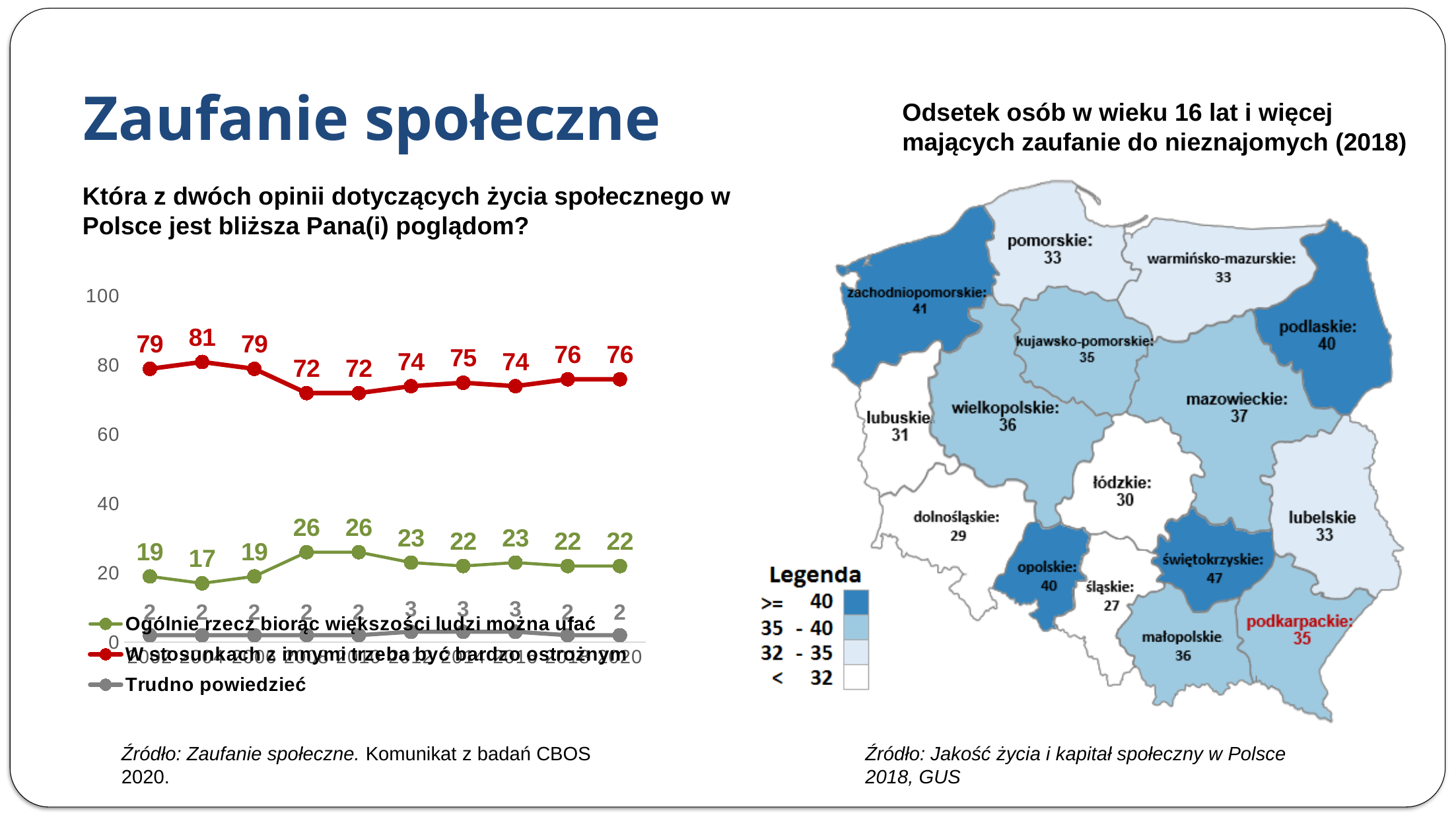
On the map on the right, which voivodeship has the lowest value? śląskie In the line chart on the left, how many series does the legend list? 3 In the line chart on the left, which series has the higher values throughout: the red series or the green series? the red series On the map on the right, what is the value shown for mazowieckie? 37 In the line chart on the left, what is the highest value of the green series 'Ogólnie rzecz biorąc większości ludzi można ufać'? 26 What kind of chart is the chart on the left of the slide? line chart In the line chart on the left, what is the lowest value of the red series 'W stosunkach z innymi trzeba być bardzo ostrożnym'? 72 In the line chart on the left, what is the highest value of the red series 'W stosunkach z innymi trzeba być bardzo ostrożnym'? 81 In the line chart on the left, what is the difference between the last value of the red series and the last value of the green series? 54 In the line chart on the left, what is the last (rightmost) value of the red series? 76 On the map on the right, what is the value shown for świętokrzyskie? 47 In the line chart on the left, how many data points does the red series have? 10